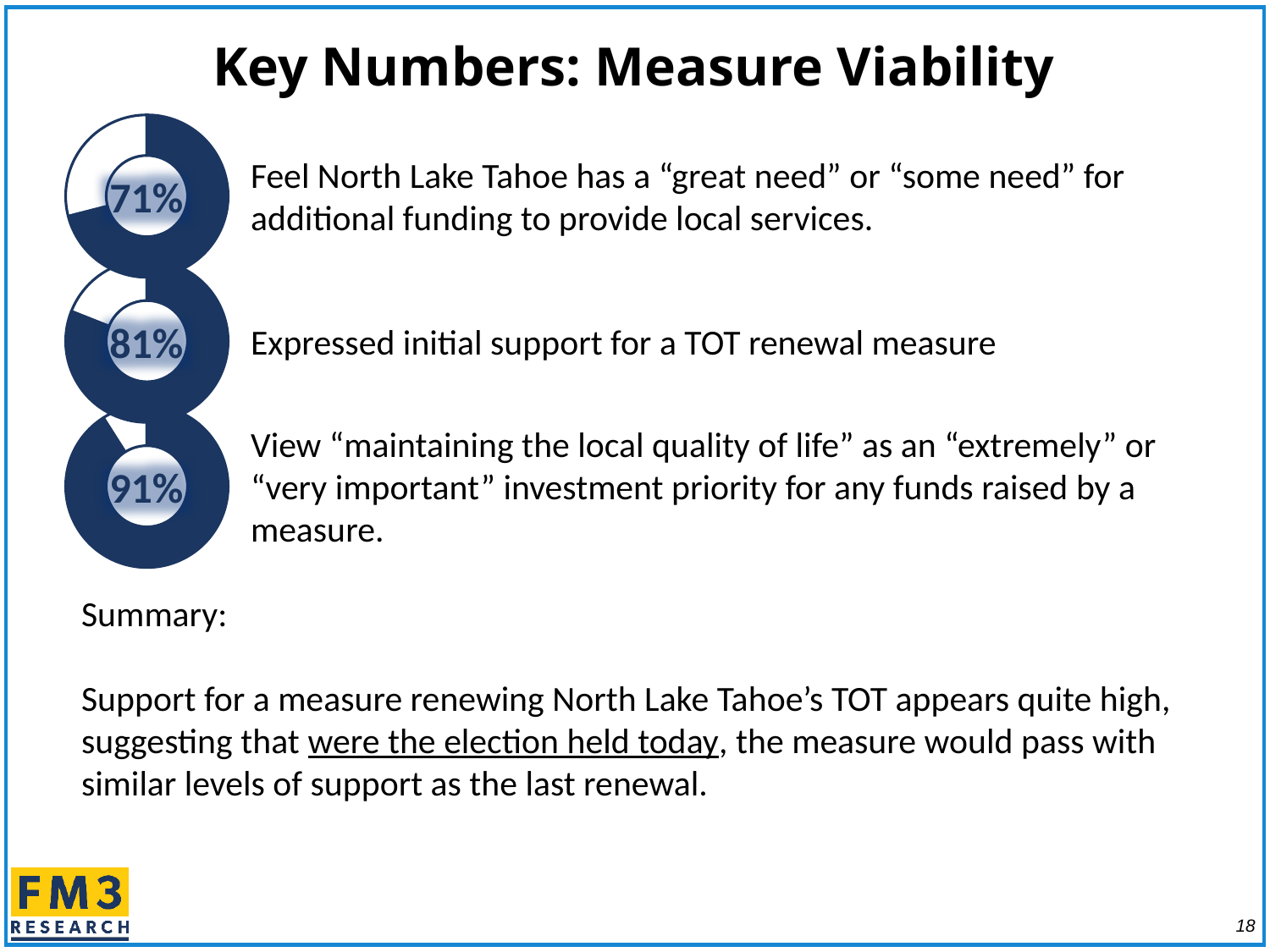
Which of the three donut charts shows the lowest percentage? The top chart (71%) Do the percentages increase or decrease going from the top donut chart to the bottom donut chart? Increase What kind of chart is used to display the key numbers on this slide? Donut chart What percentage is shown in the bottom donut chart, for those who view "maintaining the local quality of life" as an "extremely" or "very important" investment priority? 91% What is the difference between the percentage in the middle donut chart and the percentage in the top donut chart? 10 percentage points Which of the three donut charts shows the highest percentage? The bottom chart (91%) How many donut charts are shown on the slide? 3 What percentage is shown in the middle donut chart, for those who expressed initial support for a TOT renewal measure? 81% What is the difference between the percentage in the bottom donut chart and the percentage in the top donut chart? 20 percentage points What is the title of the slide containing the three donut charts? Key Numbers: Measure Viability What percentage is shown in the top donut chart, for those who feel North Lake Tahoe has a "great need" or "some need" for additional funding? 71% Which is larger: the percentage expressing initial support for a TOT renewal measure (middle chart) or the percentage feeling there is a need for additional funding (top chart)? Initial support for a TOT renewal measure (81%)